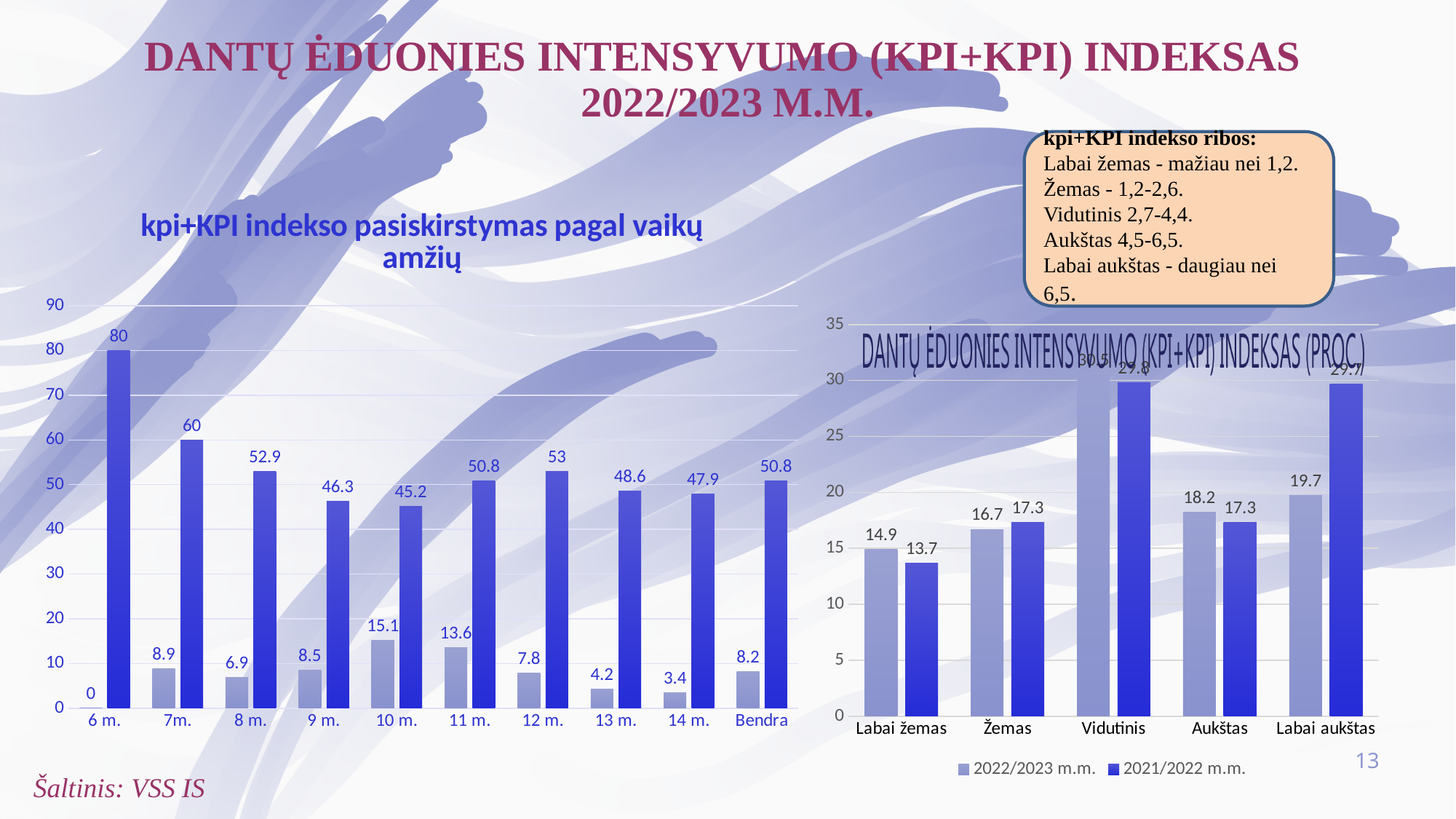
How many categories are shown on the x axis of the left chart (kpi+KPI indekso pasiskirstymas pagal vaikų amžių)? 10 In the left chart (kpi+KPI indekso pasiskirstymas pagal vaikų amžių), which category has the lowest grey bar? 6 m. In the left chart (kpi+KPI indekso pasiskirstymas pagal vaikų amžių), what is the value of the blue bar for 6 m.? 80 How many series does the legend of the right chart (DANTŲ ĖDUONIES INTENSYVUMO (KPI+KPI) INDEKSAS (PROC.)) list? 2 In the right chart (DANTŲ ĖDUONIES INTENSYVUMO (KPI+KPI) INDEKSAS (PROC.)), is the 2022/2023 m.m. value for Vidutinis greater or less than 25? greater In the left chart (kpi+KPI indekso pasiskirstymas pagal vaikų amžių), what is the value of the grey bar for 10 m.? 15.1 What kind of chart is the left chart (kpi+KPI indekso pasiskirstymas pagal vaikų amžių)? Bar chart In the left chart (kpi+KPI indekso pasiskirstymas pagal vaikų amžių), which category has the highest blue bar? 6 m. In the right chart (DANTŲ ĖDUONIES INTENSYVUMO (KPI+KPI) INDEKSAS (PROC.)), what is the 2021/2022 m.m. value for Aukštas? 17.3 In the right chart (DANTŲ ĖDUONIES INTENSYVUMO (KPI+KPI) INDEKSAS (PROC.)), what is the 2022/2023 m.m. value for Labai žemas? 14.9 In the left chart (kpi+KPI indekso pasiskirstymas pagal vaikų amžių), what is the difference between the blue bars for 7m. and 8 m.? 7.1 In the right chart (DANTŲ ĖDUONIES INTENSYVUMO (KPI+KPI) INDEKSAS (PROC.)), which series has the larger value for Labai aukštas, 2022/2023 m.m. or 2021/2022 m.m.? 2021/2022 m.m.